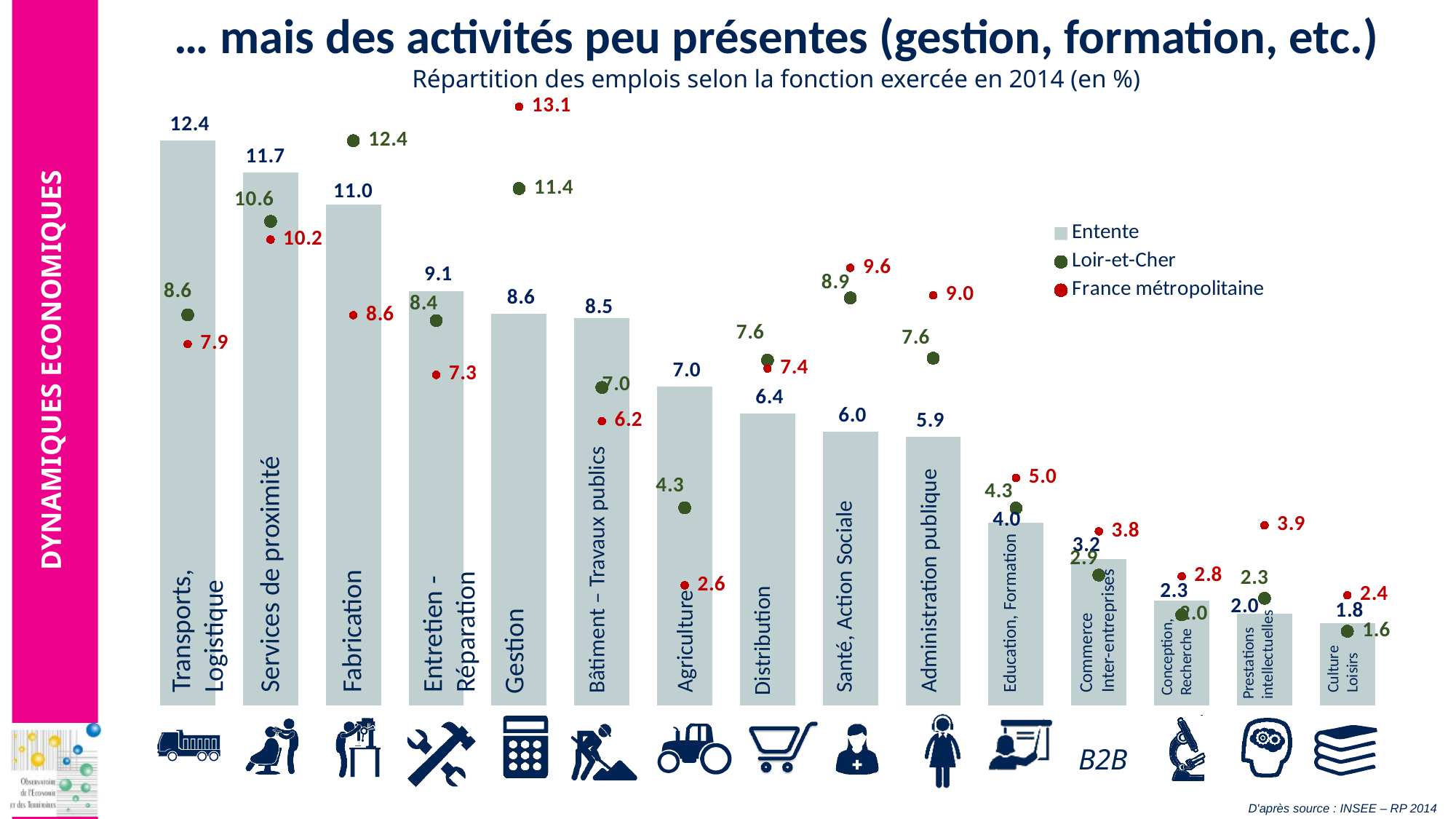
How many series does the legend list? 3 What is the Loir-et-Cher value for Fabrication? 12.4 For Agriculture, which is larger: the Entente value or the France métropolitaine value? Entente Which category has the highest Entente value? Transports, Logistique Which category has the lowest Entente value? Culture Loisirs What is the France métropolitaine value for Gestion? 13.1 What kind of chart is used to show the Entente values? Bar chart How many categories (functions) are shown on the chart? 15 Do the Entente values rise or fall from left to right across the categories? Fall What is the difference between the France métropolitaine value and the Entente value for Gestion? 4.5 What is the Entente value for Agriculture? 7.0 What is the Entente value for Transports, Logistique? 12.4